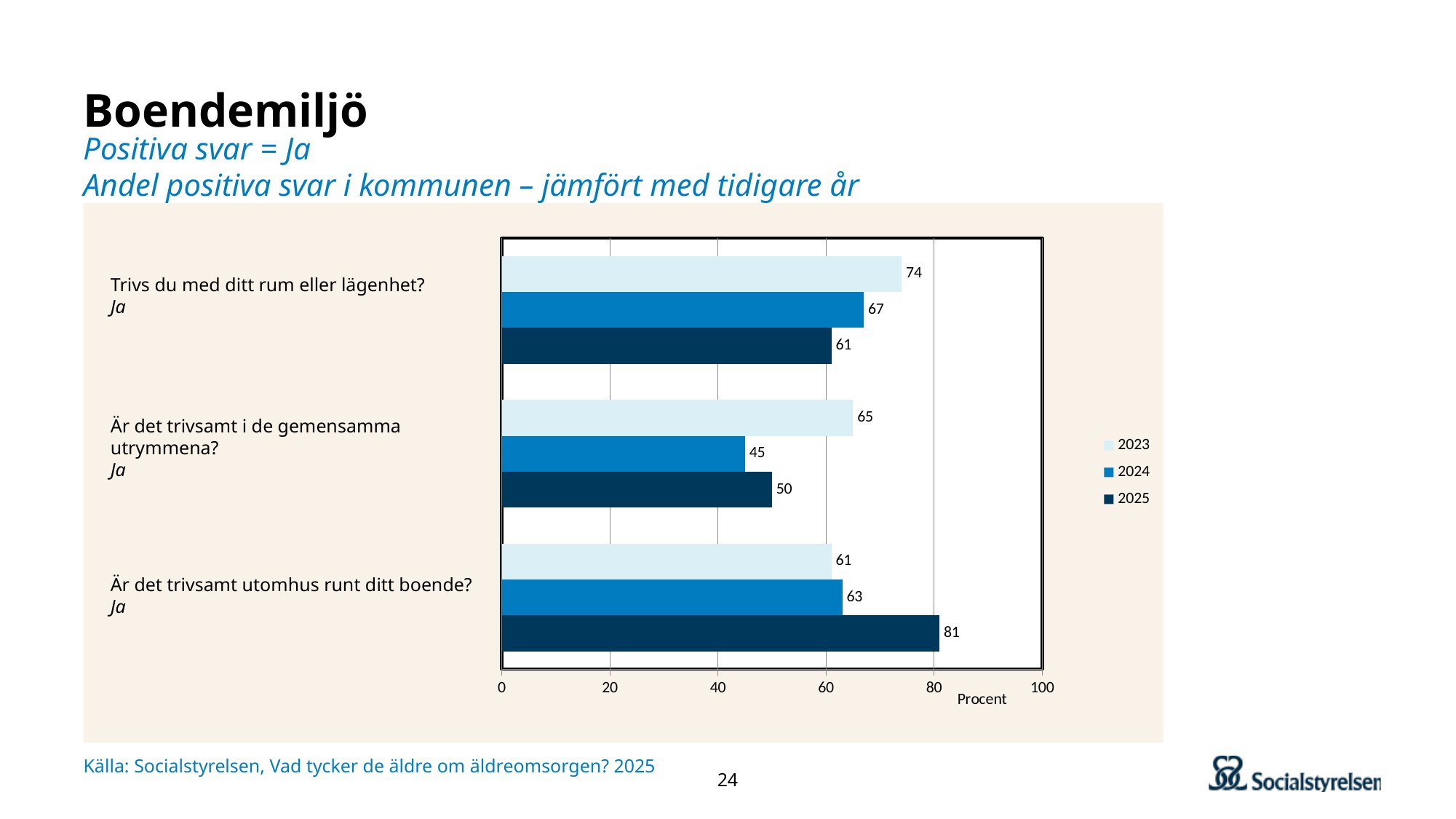
Is the 2024 value for "Är det trivsamt i de gemensamma utrymmena?" greater or less than 60? less What is the 2023 value for "Trivs du med ditt rum eller lägenhet?"? 74 What kind of chart is shown on the slide? bar chart For "Är det trivsamt utomhus runt ditt boende?", which year has the larger value, 2023 or 2025? 2025 How many questions (categories) are shown in the chart? 3 What is the label of the horizontal axis? Procent Which question has the highest 2025 value? Är det trivsamt utomhus runt ditt boende? What is the 2024 value for "Är det trivsamt i de gemensamma utrymmena?"? 45 Which question has the lowest 2024 value? Är det trivsamt i de gemensamma utrymmena? What is the difference between the 2023 and 2025 values for "Trivs du med ditt rum eller lägenhet?"? 13 What is the 2025 value for "Är det trivsamt utomhus runt ditt boende?"? 81 How many series does the legend list? 3